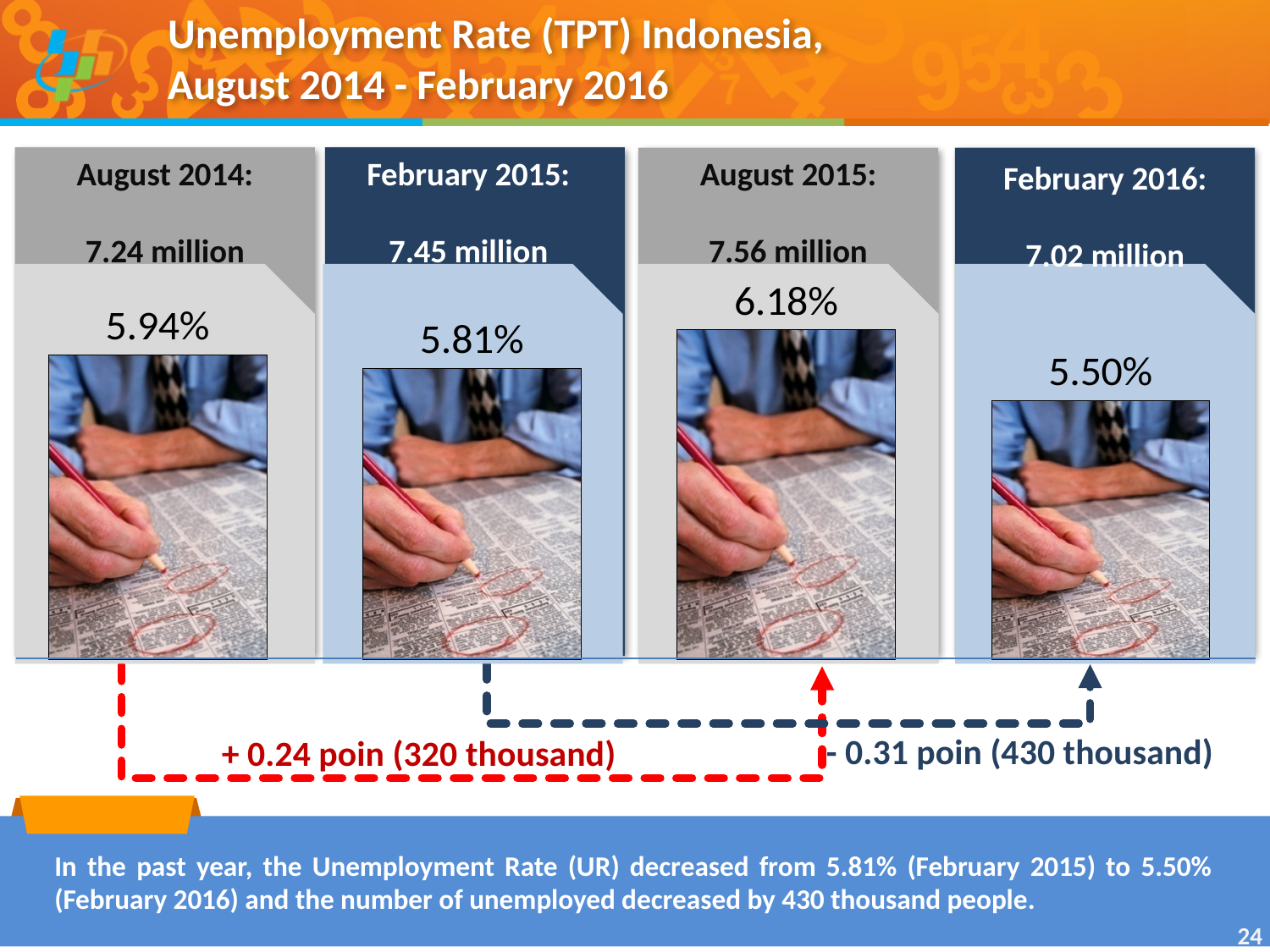
What is the title of the slide? Unemployment Rate (TPT) Indonesia, August 2014 - February 2016 What was the unemployment rate in August 2014? 5.94% Which period shows the highest unemployment rate? August 2015 How many time periods are shown on the slide? 4 How many people were unemployed in August 2015? 7.56 million What was the unemployment rate in February 2016? 5.50% By how many percentage points did the unemployment rate change from August 2014 to August 2015? + 0.24 poin Which period shows the lowest number of unemployed people? February 2016 How many people were unemployed in February 2015? 7.45 million By how many percentage points did the unemployment rate change from February 2015 to February 2016? - 0.31 poin Which is larger, the unemployment rate in February 2015 or in August 2014? August 2014 Did the unemployment rate rise or fall from February 2015 to February 2016? fall